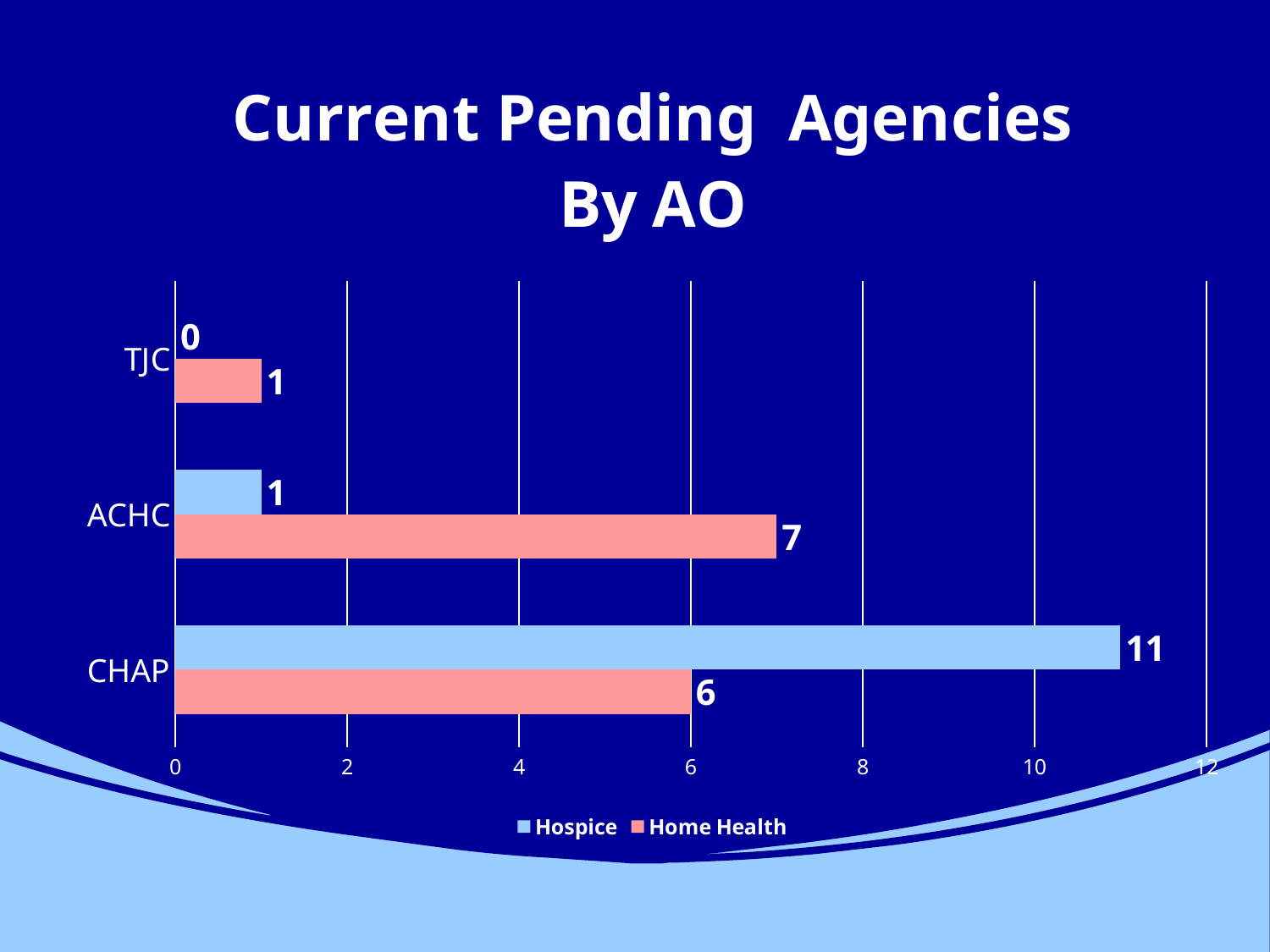
What kind of chart is shown on the slide? Bar chart Which AO has the lowest Home Health value? TJC What is the title of the chart? Current Pending Agencies By AO Which AO has the highest Hospice value? CHAP What is the Home Health value for ACHC? 7 What is the Hospice value for CHAP? 11 What is the difference between the Hospice and Home Health values for CHAP? 5 How many AO categories are shown on the chart? 3 How many series does the legend list? 2 For ACHC, which is larger: Hospice or Home Health? Home Health What is the Home Health value for CHAP? 6 What is the Hospice value for TJC? 0